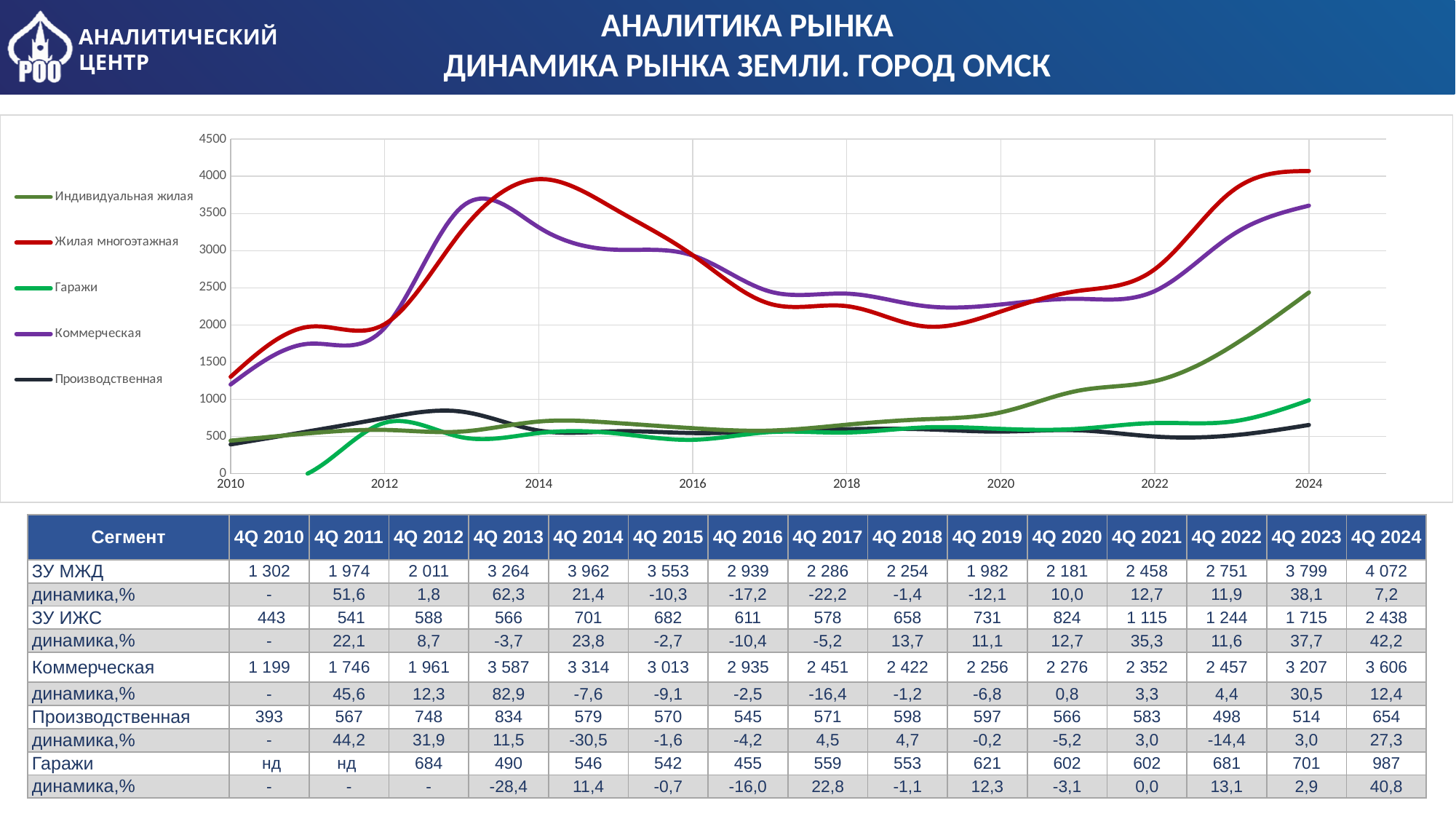
Which is larger in 4Q 2013: Коммерческая or ЗУ МЖД? Коммерческая Which series has the highest value in 2024? Жилая многоэтажная Is the value for Коммерческая in 2014 greater or less than 3000? greater What is the value for Производственная in 4Q 2013? 834 Does the Индивидуальная жилая line rise or fall from 2020 to 2024? rises What is the value for Гаражи in 4Q 2024? 987 What kind of chart is shown on the slide? line chart Which series has the lowest value in 2024? Производственная How many series does the chart legend list? 5 What is the value for ЗУ МЖД in 4Q 2024? 4 072 How many quarterly periods are listed in the table columns? 15 What is the difference between the ЗУ МЖД values in 4Q 2024 and 4Q 2023? 273